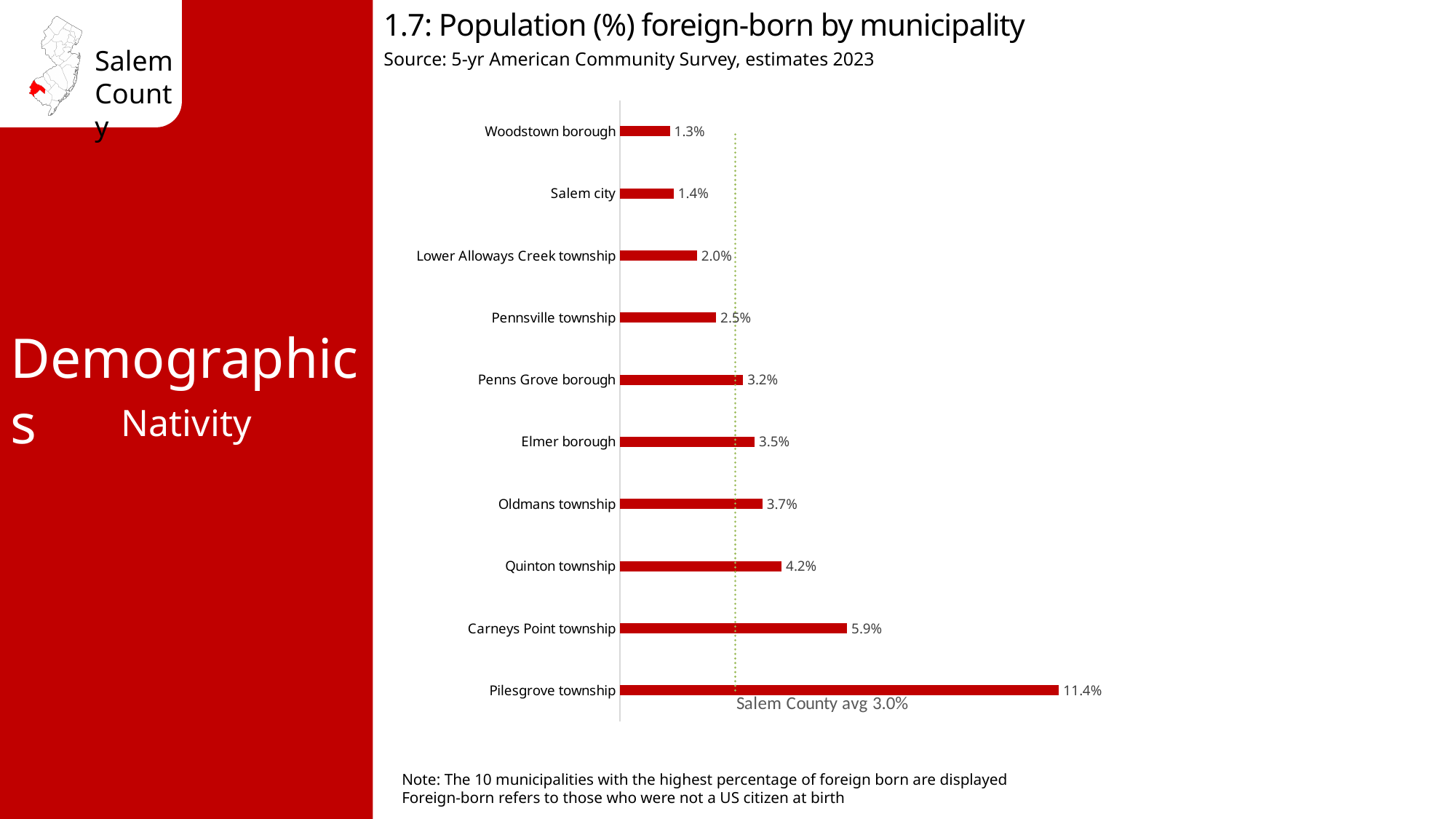
What is the source of the data in the chart? 5-yr American Community Survey, estimates 2023 What is the difference in foreign-born percentage between Oldmans township and Pennsville township? 1.2% Which has a higher foreign-born percentage, Quinton township or Elmer borough? Quinton township What is the Salem County average foreign-born percentage shown by the dotted line? 3.0% What is the difference in foreign-born percentage between Pilesgrove township and Carneys Point township? 5.5% Which municipality has the lowest percentage of foreign-born population? Woodstown borough What kind of chart is used to show the foreign-born population by municipality? Bar chart What is the foreign-born population percentage for Carneys Point township? 5.9% Which municipality has the highest percentage of foreign-born population? Pilesgrove township What is the foreign-born population percentage for Pilesgrove township? 11.4% How many municipalities are shown in the chart? 10 What is the foreign-born population percentage for Salem city? 1.4%